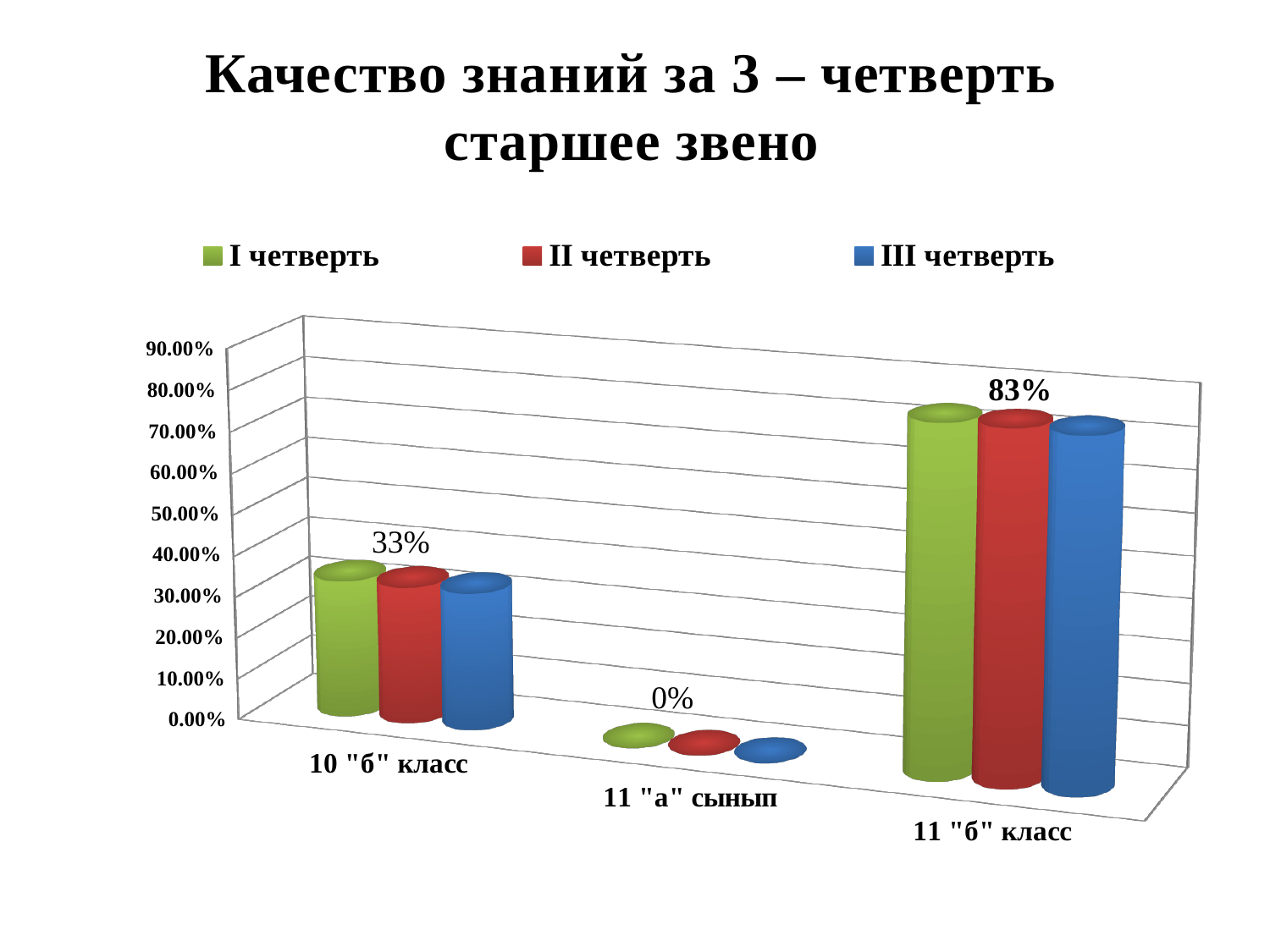
What value is labelled for 11 "б" класс? 83% Is the value for 11 "б" класс greater or less than 50.00%? greater How many series does the legend list? 3 What is the difference between the labelled values for 11 "б" класс and 10 "б" класс? 50% Which is larger, the labelled value for 10 "б" класс or for 11 "б" класс? 11 "б" класс How many classes (categories) are shown on the x axis? 3 What value is labelled for 11 "а" сынып? 0% What value is labelled for 10 "б" класс? 33% Which class has the lowest labelled value? 11 "а" сынып What kind of chart is shown on the slide? bar chart What colour represents III четверть in the legend? blue Which class has the highest labelled value? 11 "б" класс